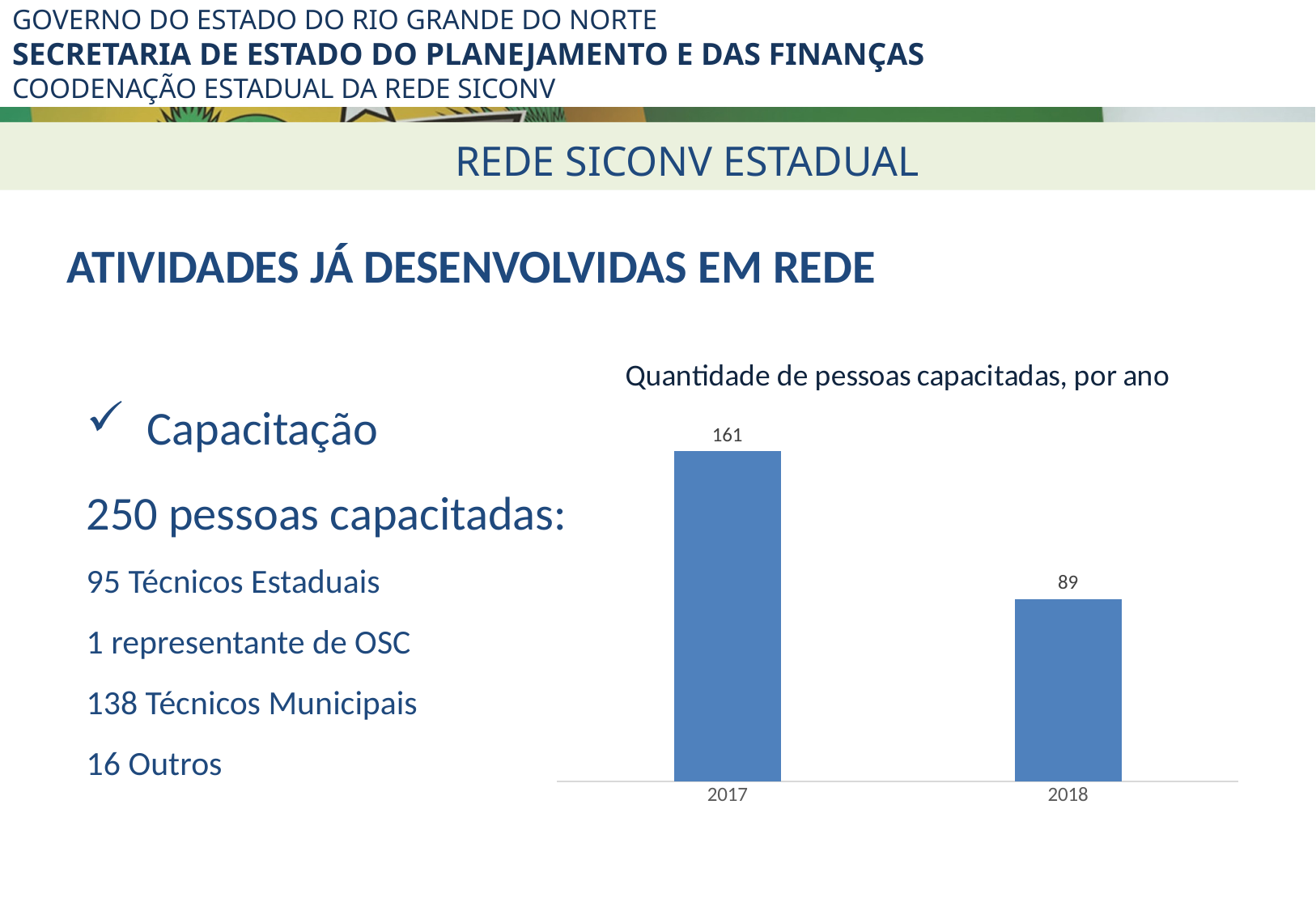
What is the value for 2018 in the chart? 89 What is the total of the values for 2017 and 2018? 250 What colour are the bars in the chart? Blue Which year has the highest number of people trained? 2017 What kind of chart is shown on the slide? Bar chart Which year has the lowest number of people trained? 2018 How many years are shown on the x axis of the chart? 2 What is the value for 2017 in the chart? 161 Which is larger, the value for 2017 or the value for 2018? 2017 Do the values rise or fall from 2017 to 2018? Fall What is the difference between the values for 2017 and 2018? 72 What is the title of the chart? Quantidade de pessoas capacitadas, por ano